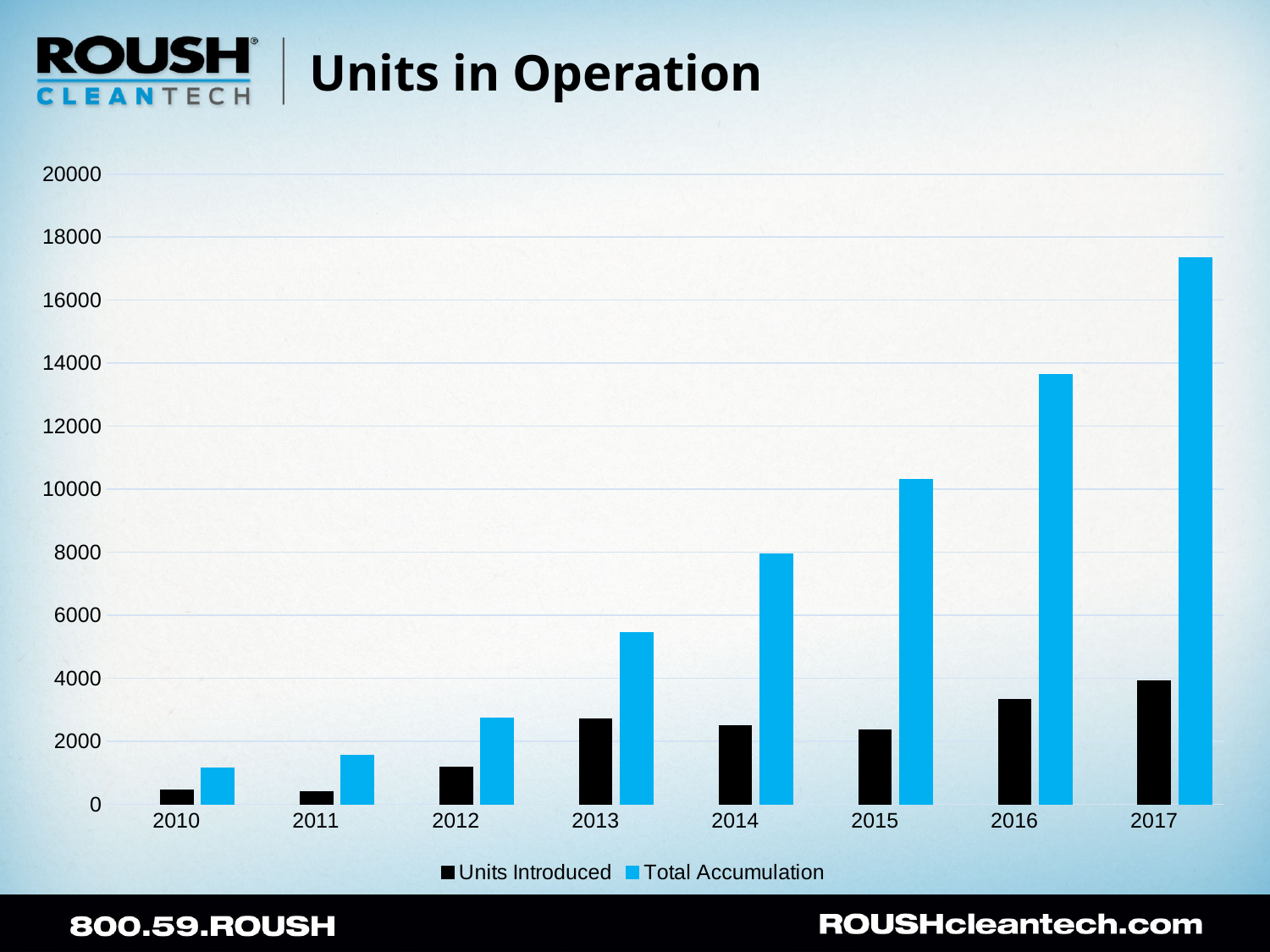
Does Total Accumulation rise or fall from 2010 to 2017? rise Is the Total Accumulation for 2013 greater or less than 6000? less Which is larger, Units Introduced in 2016 or Units Introduced in 2015? 2016 Is the Units Introduced value for 2012 greater or less than 2000? less What type of chart is shown on the slide? bar chart Which year has the lowest Total Accumulation? 2010 Is the Total Accumulation for 2017 greater or less than 16000? greater Which year has the highest Total Accumulation? 2017 How many years are shown on the x axis? 8 Which year has the highest Units Introduced? 2017 How many series does the legend list? 2